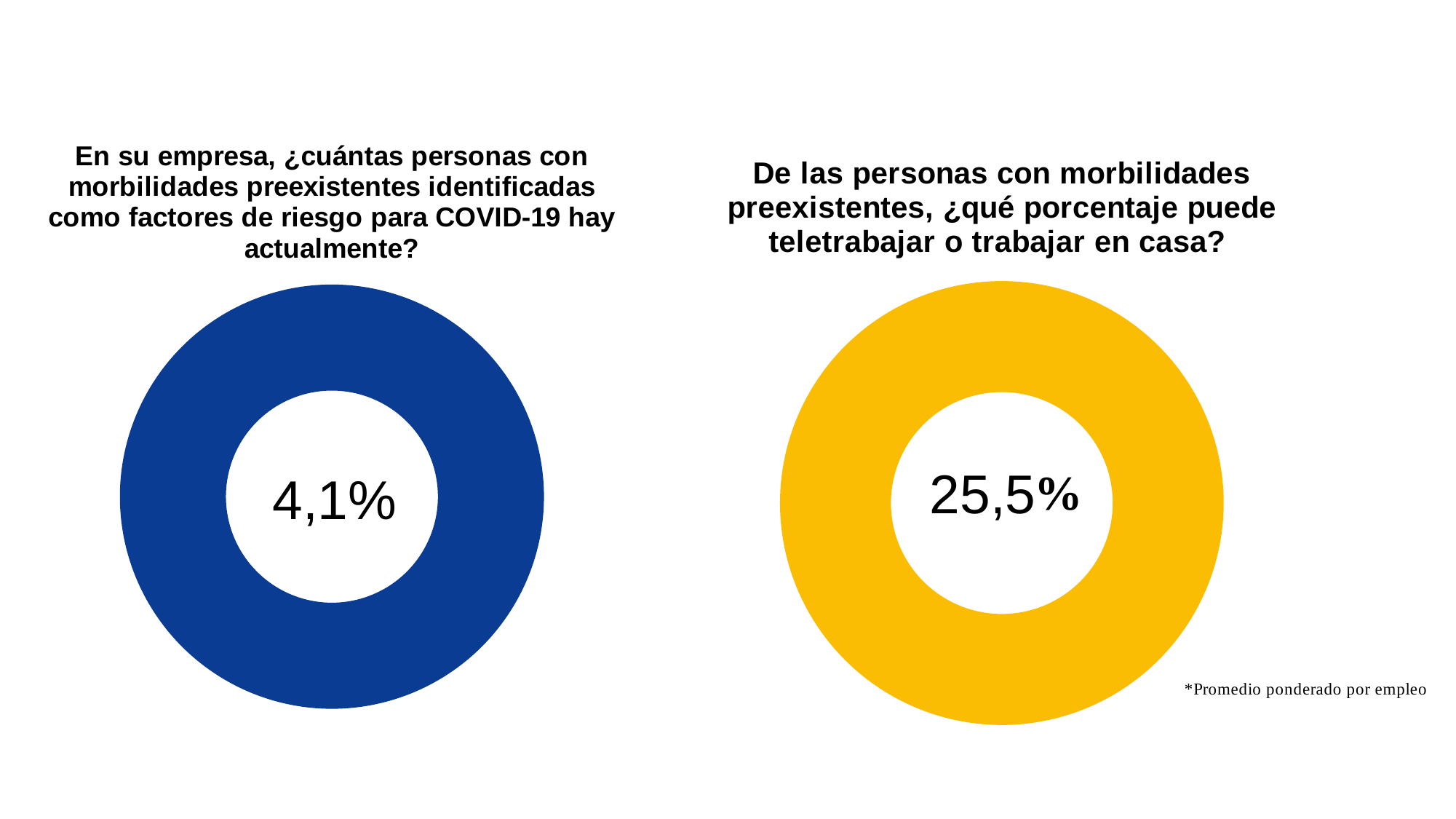
What value is shown in the centre of the right donut chart titled "De las personas con morbilidades preexistentes, ¿qué porcentaje puede teletrabajar o trabajar en casa?"? 25,5% What kind of chart is used on the right side of the slide? Donut (pie) chart How many donut charts are shown on the slide? 2 What colour is the ring of the left donut chart? Blue What footnote appears below the right donut chart? *Promedio ponderado por empleo What kind of chart is used on the left side of the slide? Donut (pie) chart Which chart shows the larger value, the left chart (4,1%) or the right chart (25,5%)? The right chart (25,5%) What value is shown in the centre of the left donut chart titled "En su empresa, ¿cuántas personas con morbilidades preexistentes identificadas como factores de riesgo para COVID-19 hay actualmente?"? 4,1% What is the difference between the value in the right chart (25,5%) and the value in the left chart (4,1%)? 21,4% Is the value shown in the left donut chart greater or less than 5%? less Is the value shown in the right donut chart greater or less than 20%? greater